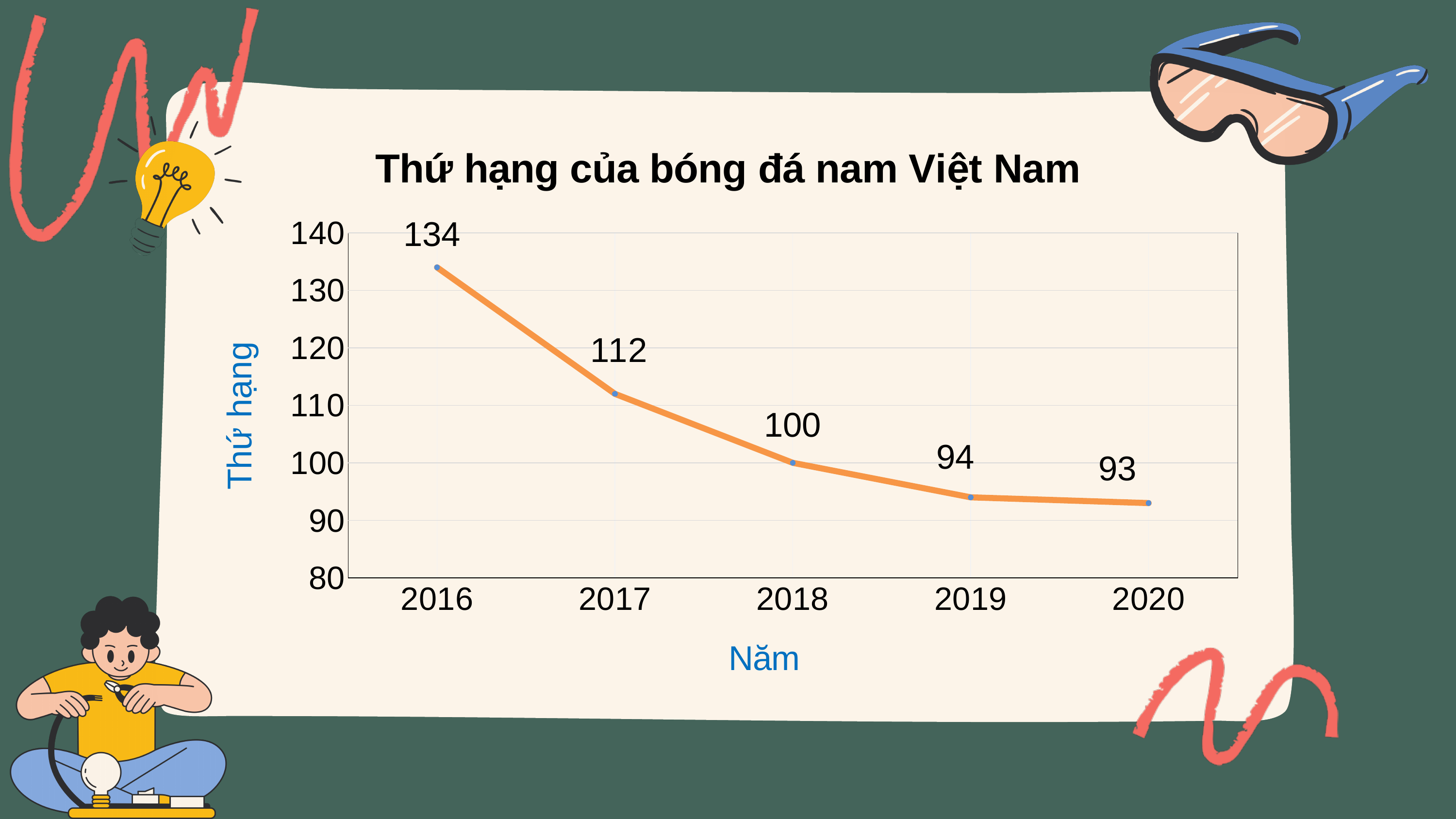
What is the difference between the values for 2016 and 2017? 22 Do the values rise or fall from 2016 to 2020? fall What is the title of the chart? Thứ hạng của bóng đá nam Việt Nam What is the ranking value shown for 2018? 100 What is the ranking value shown for 2016? 134 How many years are plotted on the chart? 5 Which year has the highest value on the chart? 2016 What is the ranking value shown for 2020? 93 What is the difference between the values for 2018 and 2019? 6 Which year has the lowest value on the chart? 2020 Which is larger, the value for 2017 or the value for 2019? 2017 What kind of chart is shown on the slide? line chart